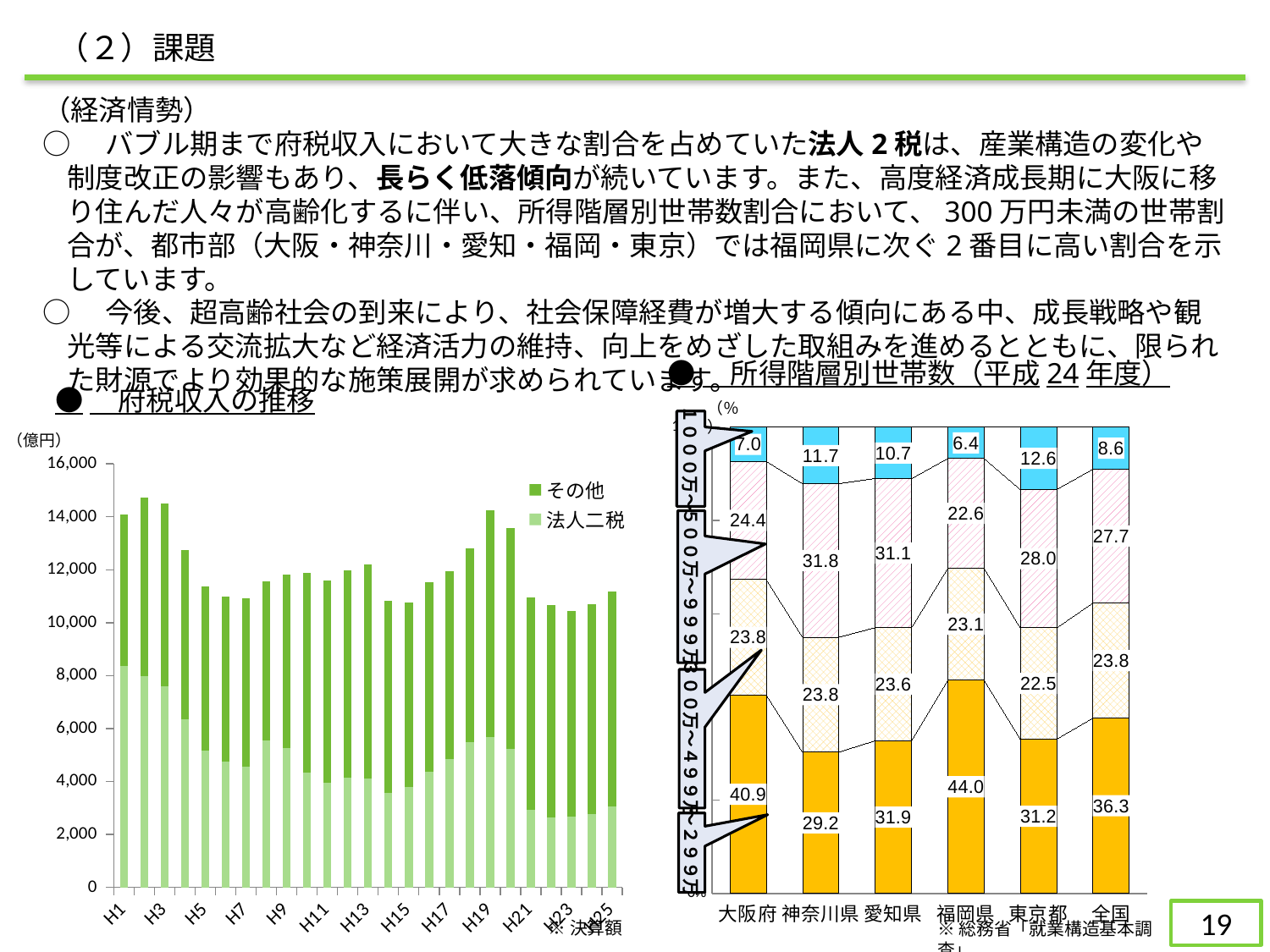
In the right chart (所得階層別世帯数), what is the value of the 500万～999万 segment for 東京都? 28.0 In the left chart (府税収入の推移), is the total bar height for H3 greater or less than 14,000? greater How many series does the legend of the left chart (府税収入の推移) list? 2 In the right chart (所得階層別世帯数), which category has the lowest value for the top blue segment (1000万～)? 福岡県 In the left chart (府税収入の推移), does the 法人二税 series generally rise or fall from H1 to H25? fall In the left chart (府税収入の推移), is the 法人二税 value for H25 greater or less than 4,000? less In the right chart (所得階層別世帯数), which has the larger top blue segment value, 神奈川県 or 愛知県? 神奈川県 In the right chart (所得階層別世帯数), how many categories are shown on the x axis? 6 In the right chart (所得階層別世帯数), what is the difference between the bottom orange segment values for 福岡県 and 大阪府? 3.1 In the right chart (所得階層別世帯数), which category has the highest value for the bottom orange segment (～299万)? 福岡県 In the right chart (所得階層別世帯数), what is the value of the bottom orange segment (～299万) for 大阪府? 40.9 What kind of chart is the left chart (府税収入の推移)? Stacked bar chart